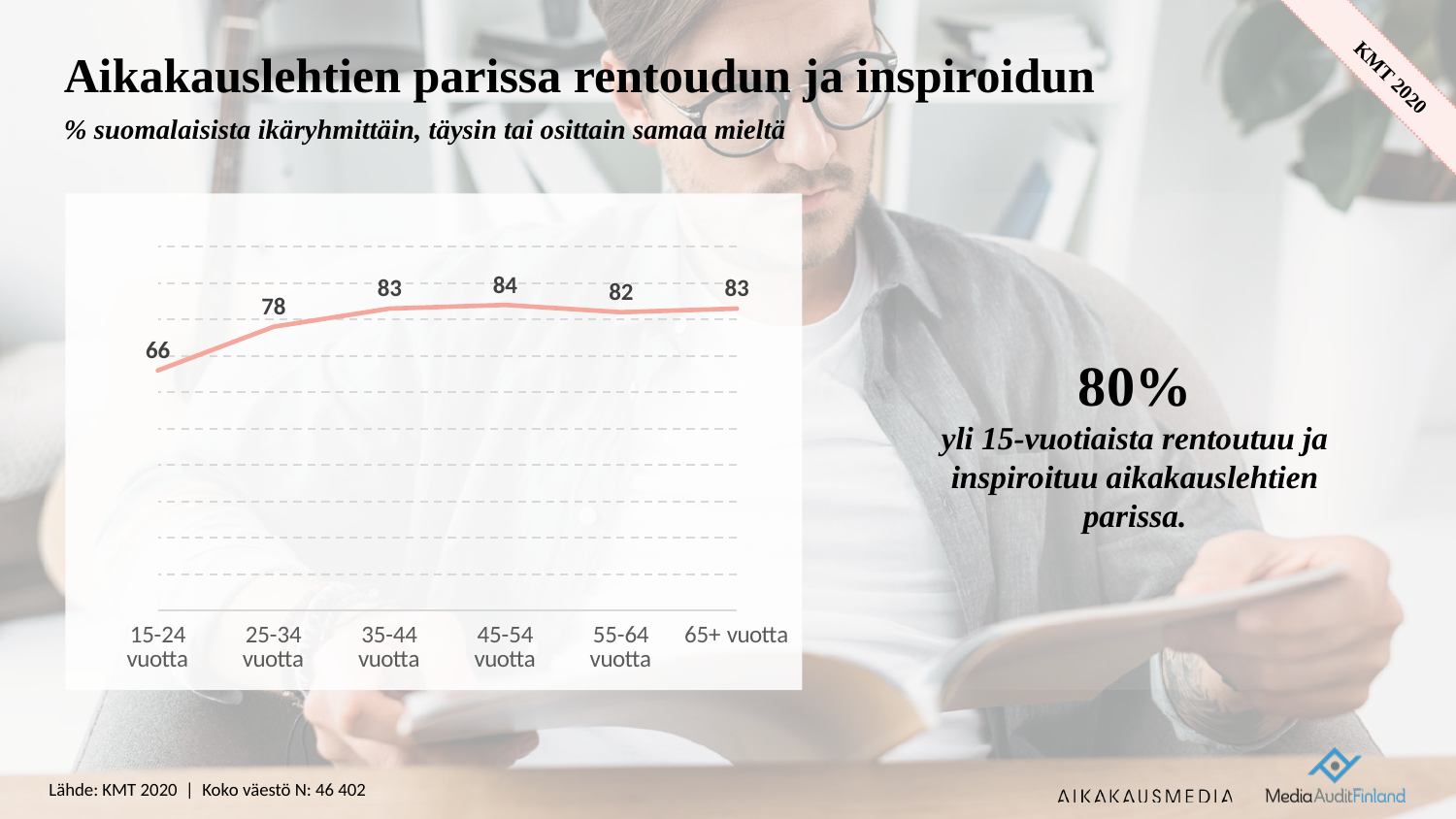
Does the line rise or fall from 15-24 vuotta to 45-54 vuotta? rise What is the value for the 15-24 vuotta age group? 66 Which age group has the highest value? 45-54 vuotta Which age group has the lowest value? 15-24 vuotta Which is larger, the value for 35-44 vuotta or the value for 55-64 vuotta? 35-44 vuotta What is the value for the 65+ vuotta age group? 83 What is the difference between the values for 25-34 vuotta and 15-24 vuotta? 12 What is the value for the 25-34 vuotta age group? 78 What is the value for the 55-64 vuotta age group? 82 What type of chart is shown on the slide? line chart How many age groups are plotted on the chart? 6 What is the value for the 45-54 vuotta age group? 84